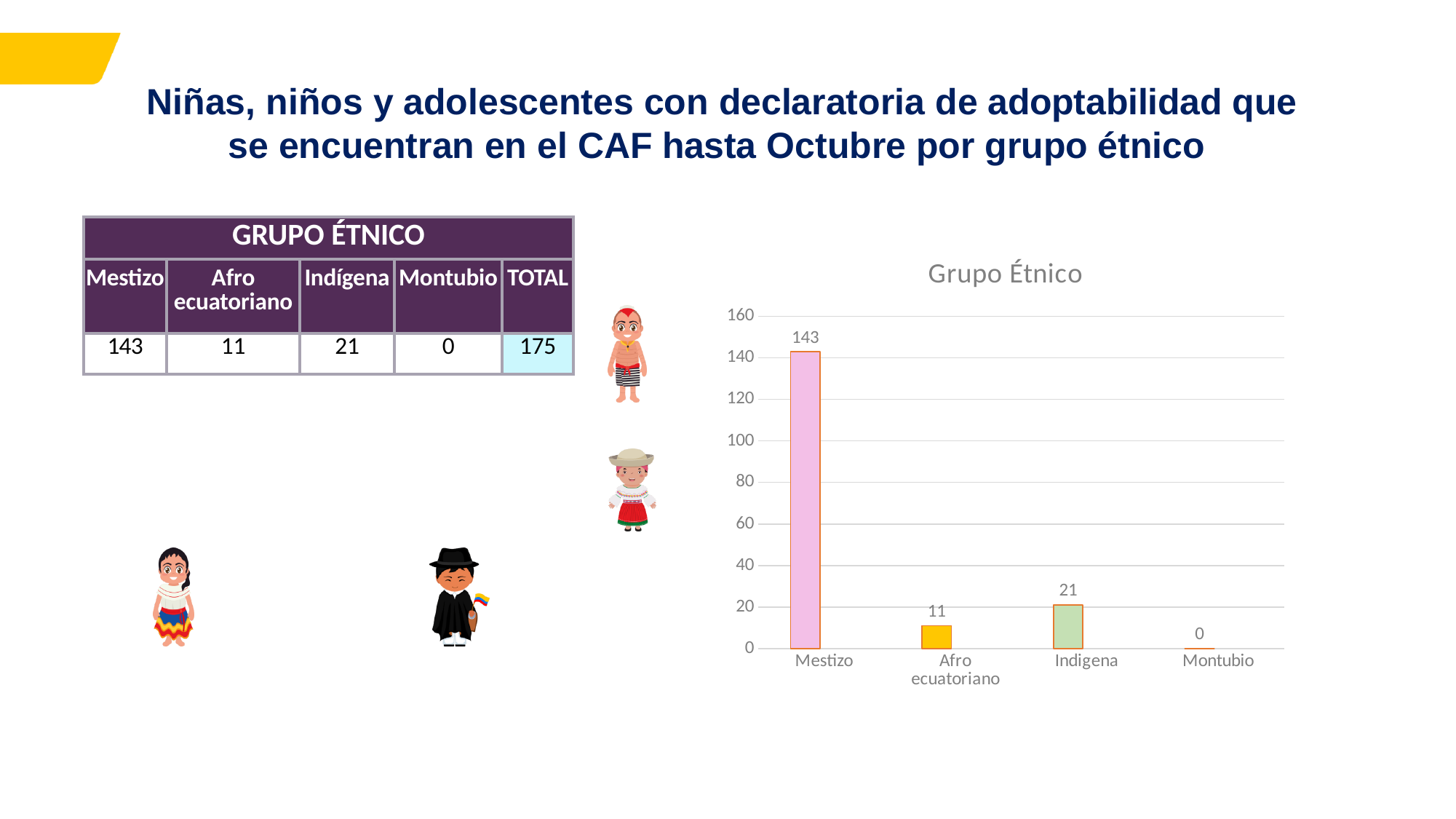
What is the value for Montubio in the Grupo Étnico chart? 0 Which category has the lowest value in the Grupo Étnico chart? Montubio What is the value for Mestizo in the Grupo Étnico chart? 143 What is the value for Afro ecuatoriano in the Grupo Étnico chart? 11 What is the difference between the values for Indigena and Afro ecuatoriano in the Grupo Étnico chart? 10 What kind of chart is the Grupo Étnico chart? bar chart What is the difference between the values for Mestizo and Indigena in the Grupo Étnico chart? 122 Which is larger in the Grupo Étnico chart, Indigena or Afro ecuatoriano? Indigena Which category has the highest value in the Grupo Étnico chart? Mestizo Is the value for Mestizo in the Grupo Étnico chart greater or less than 140? greater How many categories are shown in the Grupo Étnico chart? 4 What is the value for Indigena in the Grupo Étnico chart? 21